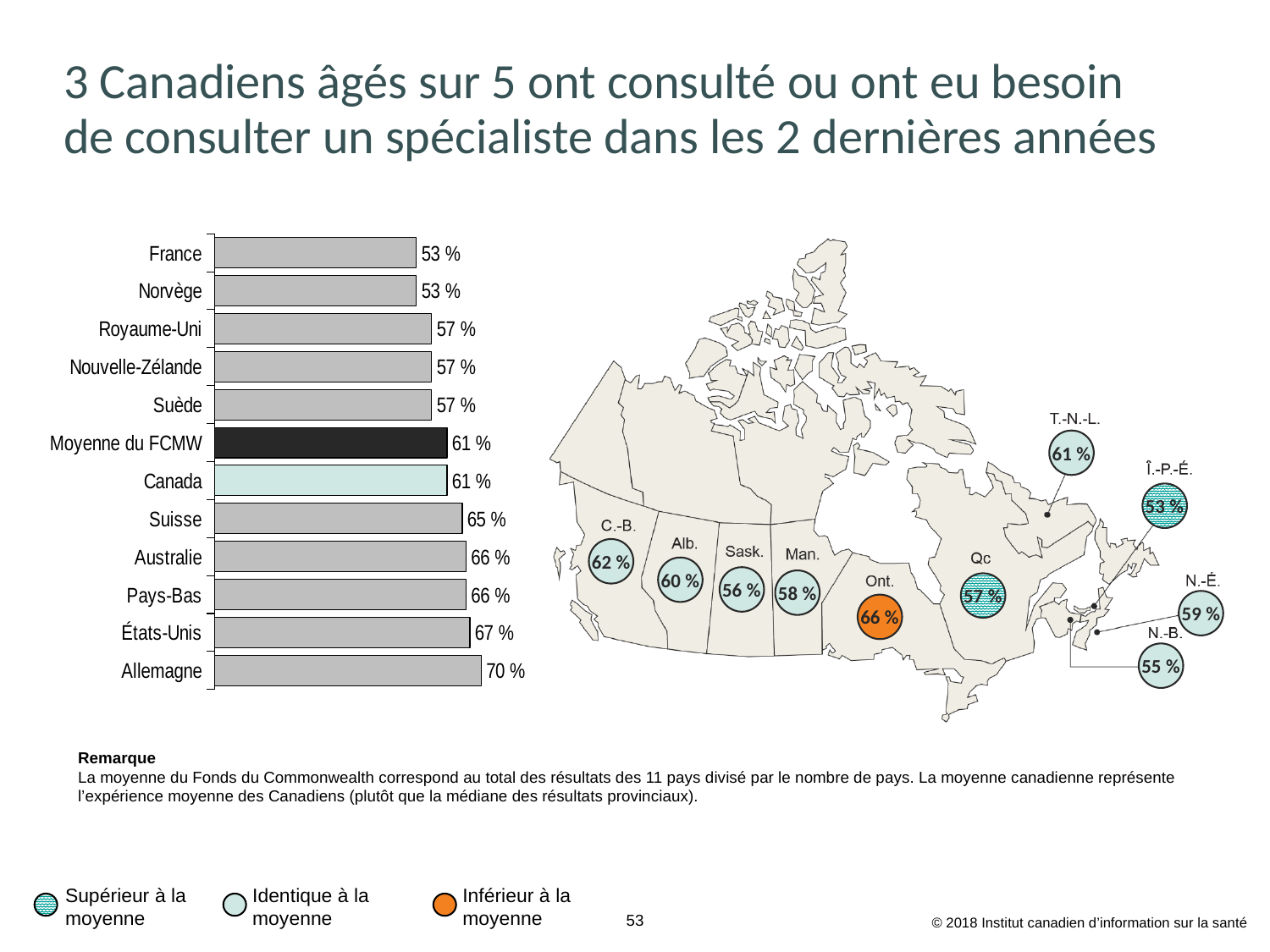
In the bar chart, which country has the highest value? Allemagne On the map of Canada, what is the value shown for Î.-P.-É.? 53 % In the bar chart, what is the value for Moyenne du FCMW? 61 % In the bar chart, what is the value for Allemagne? 70 % In the bar chart, what is the difference between the values for Allemagne and France? 17 % In the bar chart, what is the value for Suisse? 65 % On the map of Canada, what is the value shown for Ont.? 66 % In the bar chart, which is larger, the value for États-Unis or the value for Suède? États-Unis On the map of Canada, which is larger, the value for C.-B. or the value for Sask.? C.-B. In the bar chart, what is the value for Canada? 61 % In the bar chart, how many countries or categories are listed? 12 What type of chart is shown on the left of the slide? Bar chart